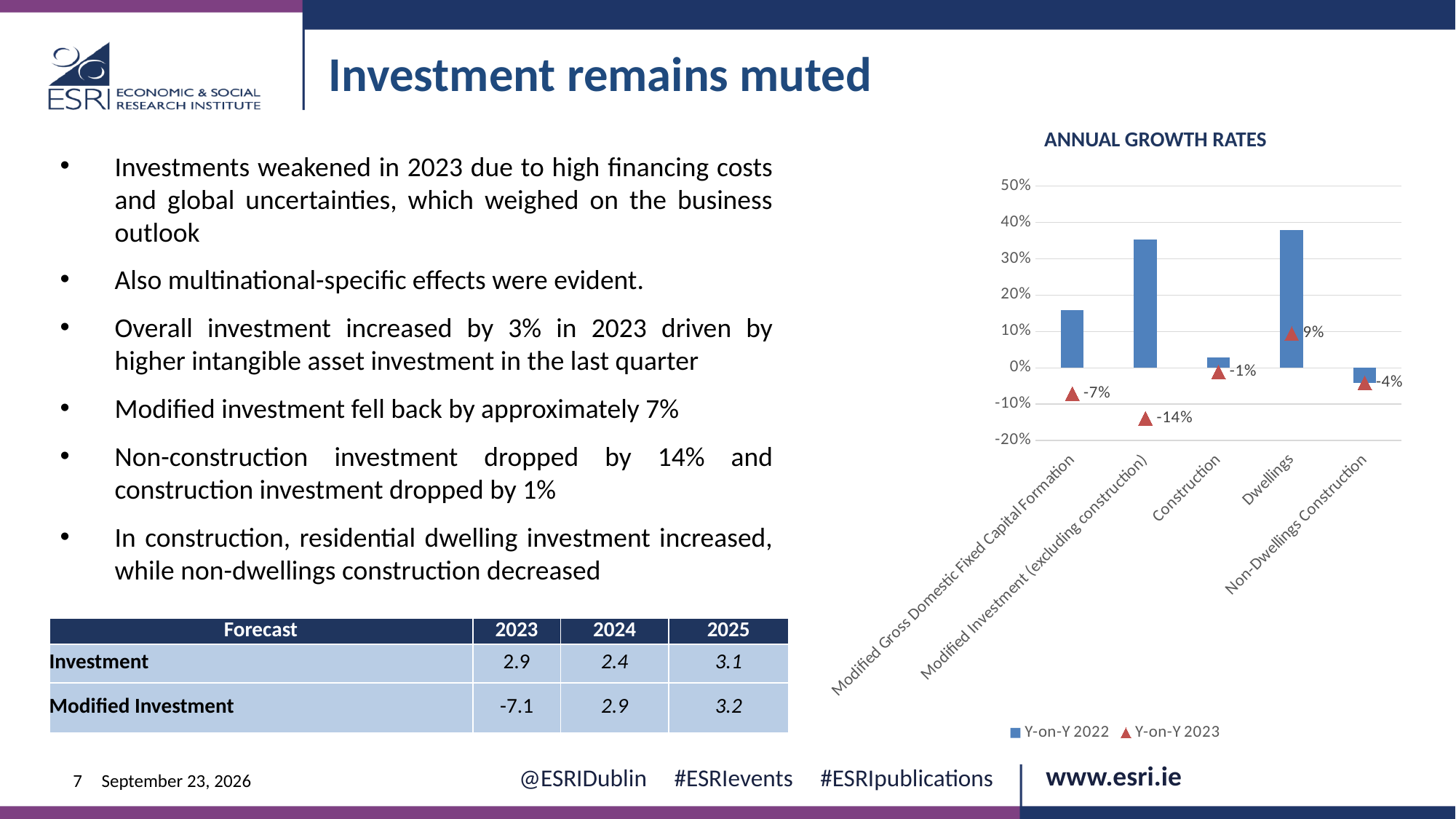
What is the Y-on-Y 2023 value for Dwellings in the Annual Growth Rates chart? 9% What type of chart is the Annual Growth Rates chart? Combination chart: bars for Y-on-Y 2022 and triangle markers for Y-on-Y 2023 What is the Y-on-Y 2023 value for Non-Dwellings Construction in the Annual Growth Rates chart? -4% Is the Y-on-Y 2022 value for Modified Gross Domestic Fixed Capital Formation greater or less than 20% in the Annual Growth Rates chart? less How many series does the legend of the Annual Growth Rates chart list? 2 What is the Y-on-Y 2023 value for Modified Investment (excluding construction) in the Annual Growth Rates chart? -14% Is the Y-on-Y 2022 value for Dwellings greater or less than 30% in the Annual Growth Rates chart? greater Which category has the highest Y-on-Y 2023 value in the Annual Growth Rates chart? Dwellings Which category has the lowest Y-on-Y 2023 value in the Annual Growth Rates chart? Modified Investment (excluding construction) What is the Y-on-Y 2023 value for Construction in the Annual Growth Rates chart? -1% What is the difference between the Y-on-Y 2023 values for Dwellings and Modified Gross Domestic Fixed Capital Formation in the Annual Growth Rates chart? 16 percentage points How many categories are shown on the x axis of the Annual Growth Rates chart? 5